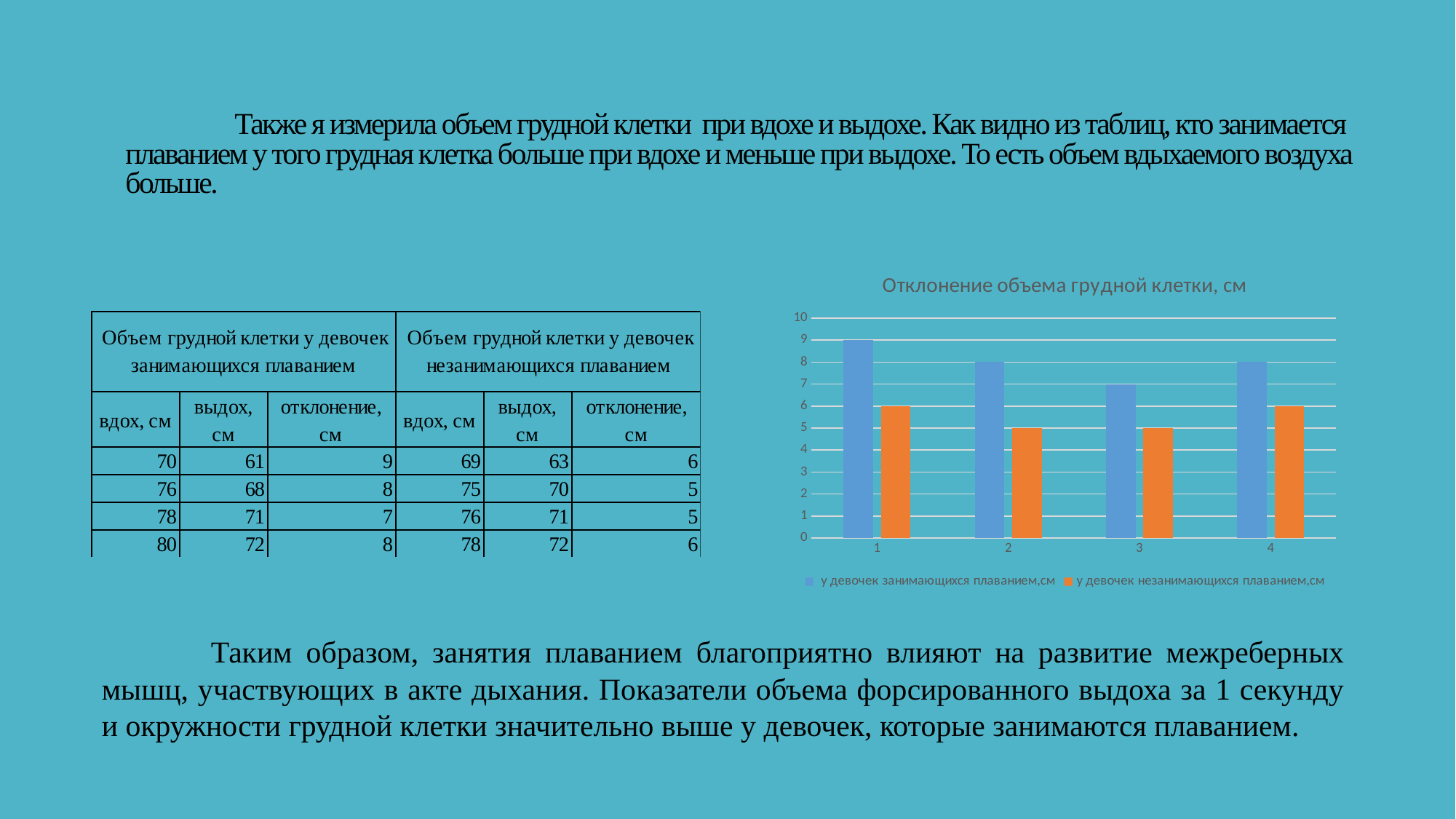
What is the title of the chart? Отклонение объема грудной клетки, см Which colour represents the series 'у девочек незанимающихся плаванием,см'? orange What is the value for category 3 in the series 'у девочек незанимающихся плаванием,см'? 5 What kind of chart is shown on the slide? bar chart How many categories are shown on the x axis of the chart? 4 What is the value for category 1 in the series 'у девочек занимающихся плаванием,см'? 9 Which category has the lowest value in the series 'у девочек занимающихся плаванием,см'? 3 Which category has the highest value in the series 'у девочек занимающихся плаванием,см'? 1 For category 4, which series has the larger value? у девочек занимающихся плаванием,см What is the difference between the two series for category 2? 3 Is the value for category 1 in the series 'у девочек незанимающихся плаванием,см' greater or less than 8? less How many series does the chart legend list? 2